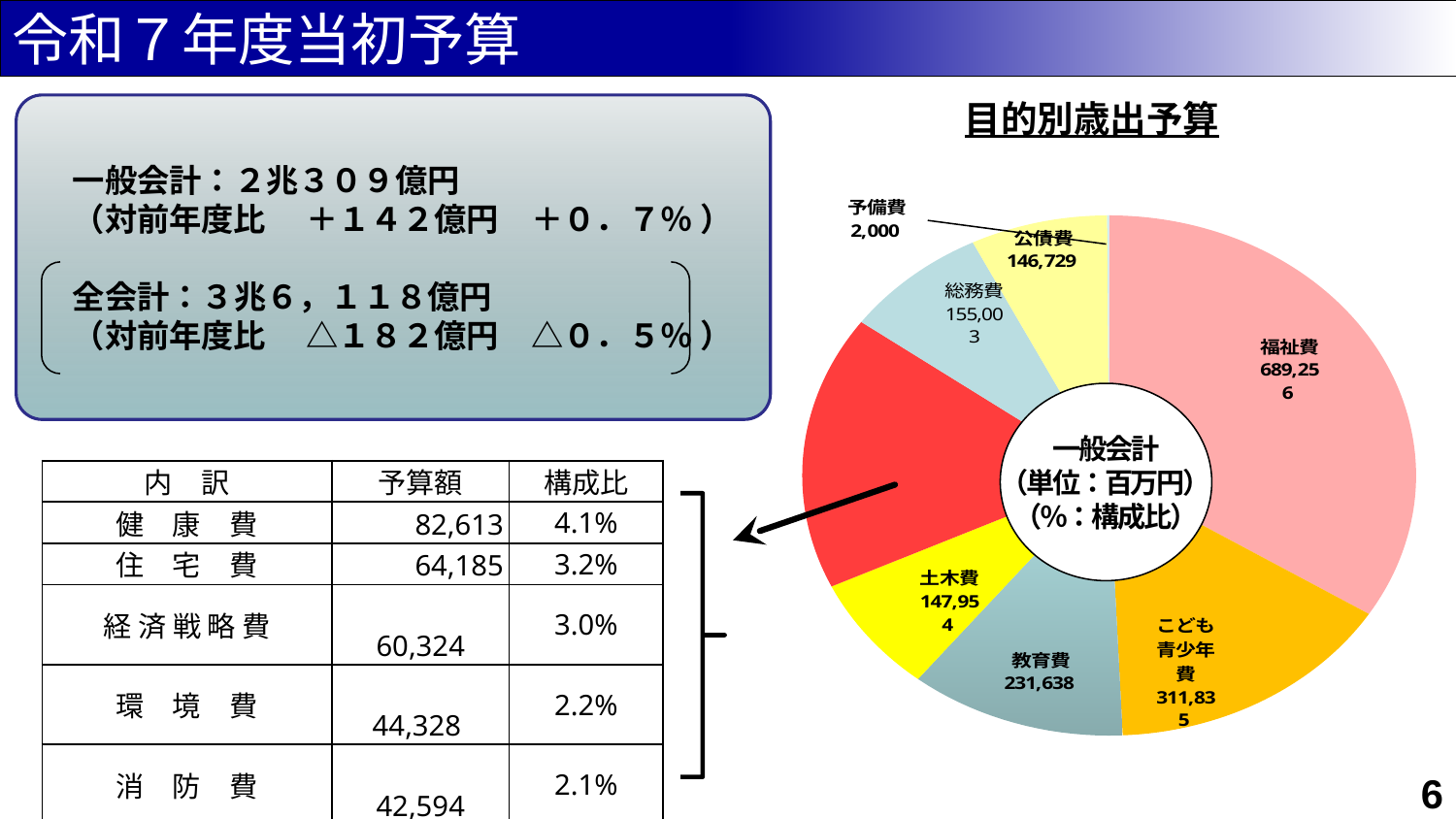
What is the value for 教育費 in the pie chart? 231,638 What is the value for こども青少年費 in the pie chart? 311,835 Which category has the largest slice in the pie chart? 福祉費 Which is larger in the pie chart, 総務費 or 公債費? 総務費 What is the value for 予備費 in the pie chart? 2,000 What is the difference between 福祉費 and こども青少年費 in the pie chart? 377,421 What is the value for 福祉費 in the pie chart? 689,256 What is the difference between 教育費 and 土木費 in the pie chart? 83,684 Which category has the smallest slice in the pie chart? 予備費 What unit is stated in the centre of the pie chart? 百万円 What is the title of the pie chart? 目的別歳出予算 What kind of chart is shown on the slide? pie chart